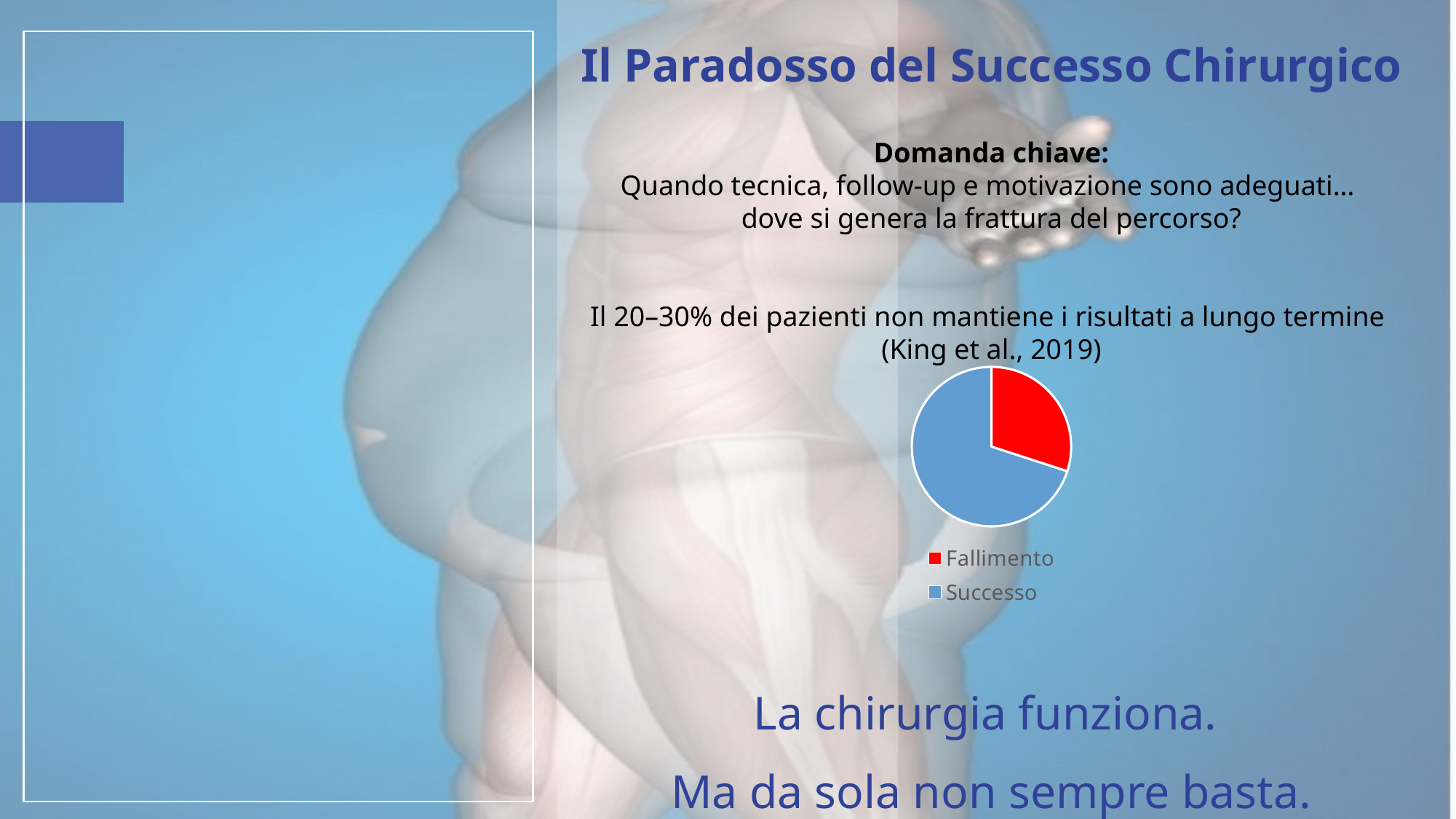
What colour is the Successo slice in the pie chart? blue Which slice is larger in the pie chart, Fallimento or Successo? Successo What kind of chart is shown on the slide? pie chart Which slice of the pie chart is the smallest? Fallimento What colour is the Fallimento slice in the pie chart? red Which slice of the pie chart is the largest? Successo How many entries does the legend of the pie chart list? 2 How many slices does the pie chart have? 2